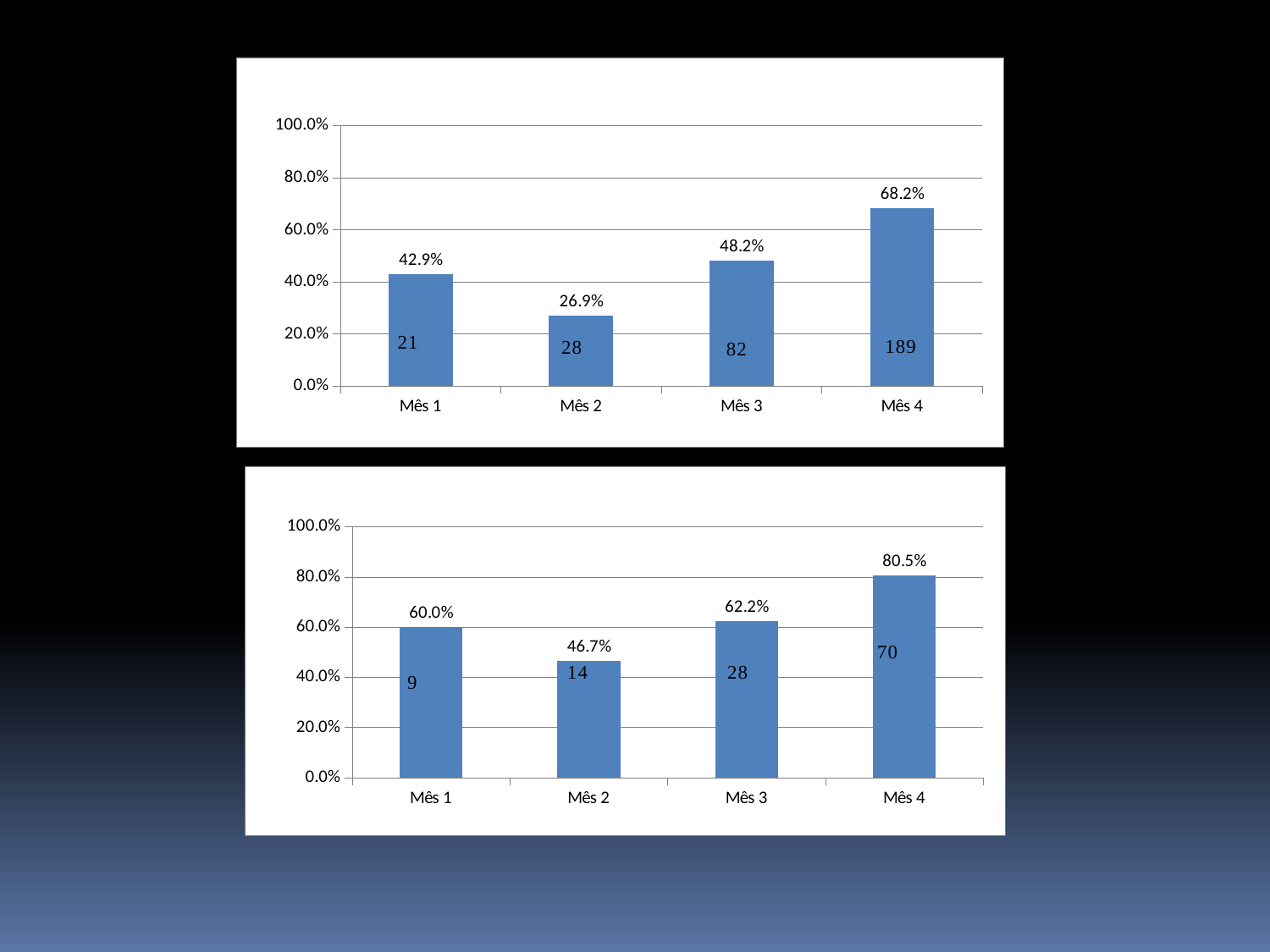
In the bottom chart, which month has the lowest percentage? Mês 2 In the top chart, which month has the lowest percentage? Mês 2 In the bottom chart, which is larger, the percentage for Mês 1 or Mês 3? Mês 3 In the bottom chart, what is the percentage value for Mês 3? 62.2% What kind of chart is the bottom chart? bar chart How many categories are shown on the x axis of the top chart? 4 In the bottom chart, is the value for Mês 4 greater or less than 80.0%? greater In the top chart, which month has the highest percentage? Mês 4 In the top chart, what is the difference between the percentages for Mês 4 and Mês 3? 20.0% In the top chart, what is the percentage value for Mês 1? 42.9% In the bottom chart, what is the percentage value for Mês 2? 46.7% In the top chart, what is the percentage value for Mês 4? 68.2%